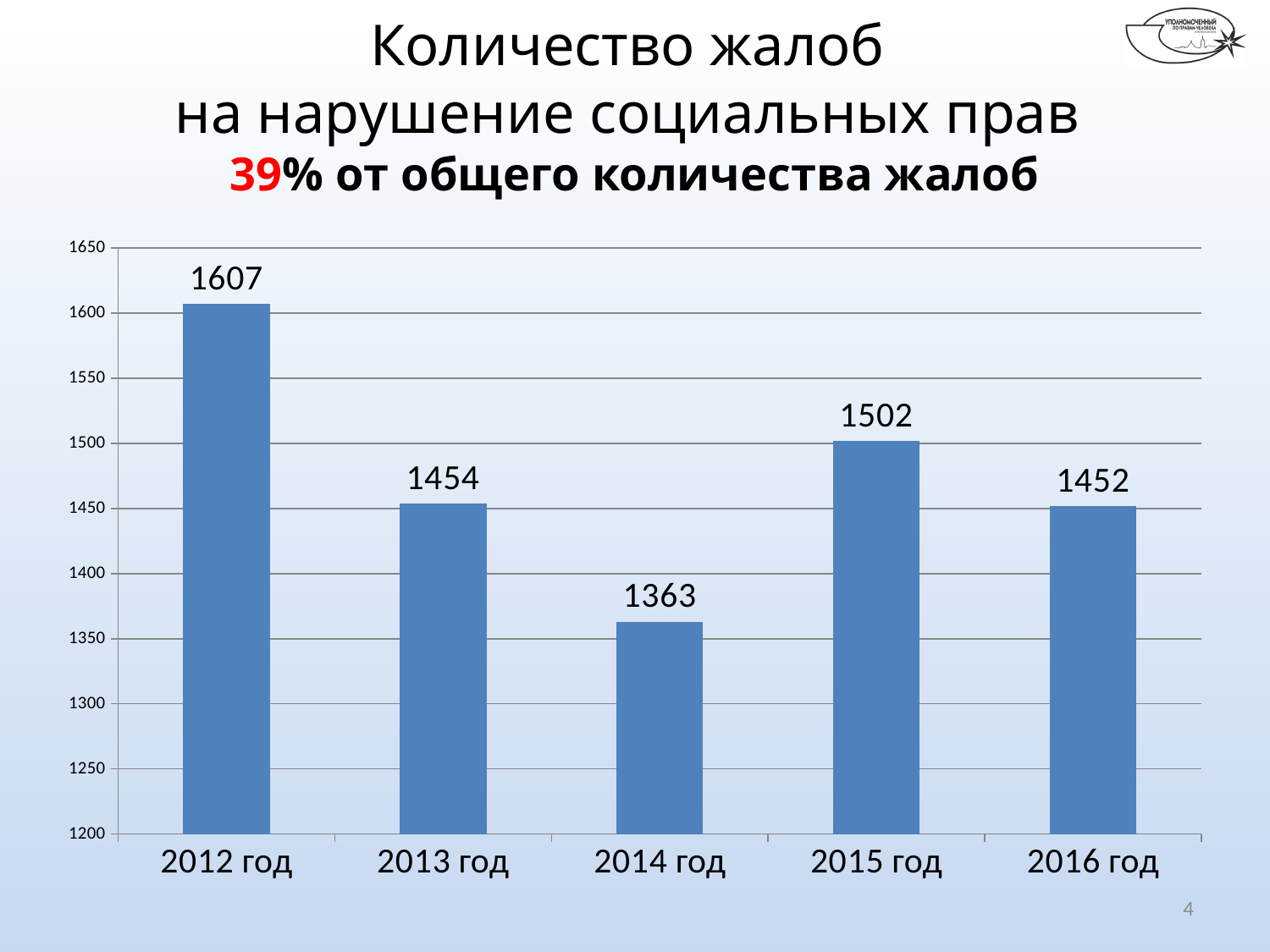
What percentage of the total number of complaints is stated in the slide title? 39% Which year has the lowest value? 2014 год Is the value for 2013 год greater or less than 1500? less What is the value for 2016 год? 1452 How many years are shown on the chart? 5 What is the difference between the values for 2012 год and 2013 год? 153 What is the difference between the values for 2015 год and 2014 год? 139 What kind of chart is shown on the slide? bar chart Which year has the highest value? 2012 год What is the value for 2014 год? 1363 Which is larger, the value for 2015 год or the value for 2016 год? 2015 год What is the value for 2012 год? 1607